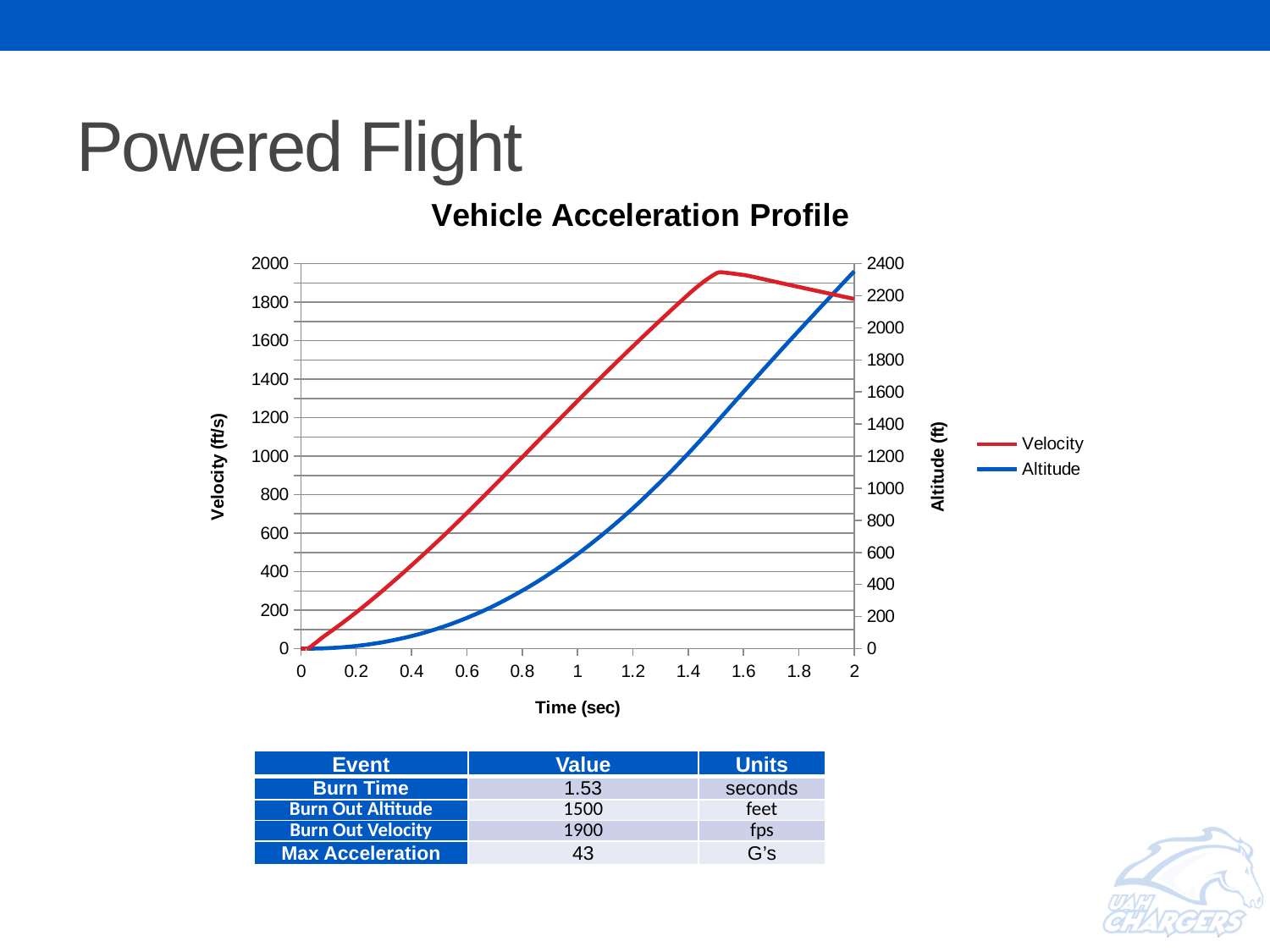
Is the Altitude value at 0.4 seconds greater or less than 200 ft? less Which series is drawn in red in the chart? Velocity Is the Velocity value at 2 seconds greater or less than 2000 ft/s? less Is the Altitude value at 1 second greater or less than 1000 ft? less What is the title of the chart? Vehicle Acceleration Profile Does the Altitude series rise or fall as time increases from 0 to 2 seconds? rise What type of chart is shown on the slide? line chart How many series does the legend of the Vehicle Acceleration Profile chart list? 2 Does the Velocity series rise or fall between 1.6 and 2 seconds? fall